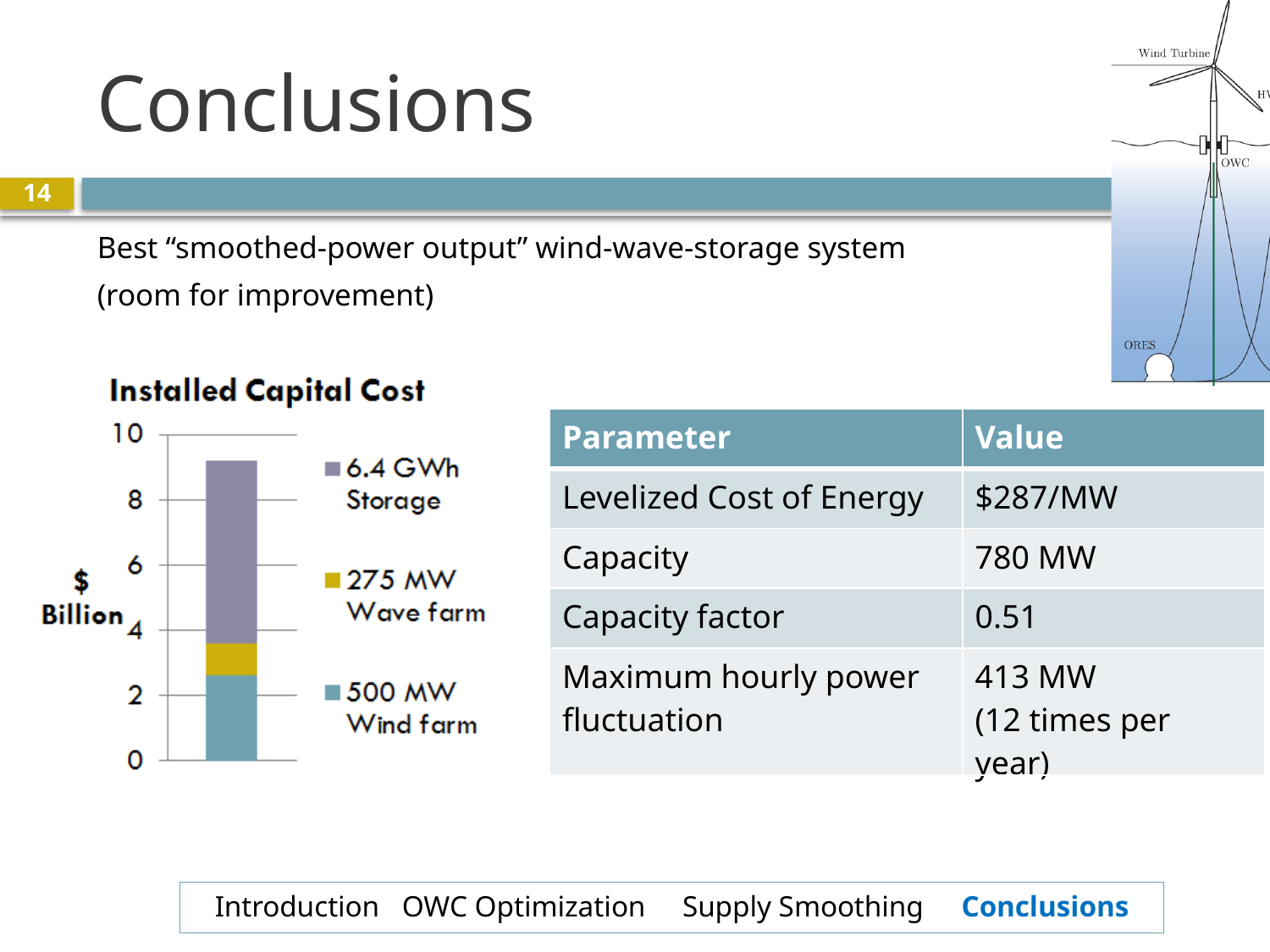
What is the unit shown on the vertical axis of the Installed Capital Cost chart? $ Billion Which component accounts for the largest share of the installed capital cost in the chart? 6.4 GWh Storage What kind of chart is the Installed Capital Cost chart? stacked bar chart Which is larger in the Installed Capital Cost chart, the 500 MW Wind farm segment or the 275 MW Wave farm segment? 500 MW Wind farm What is the title of the chart on the slide? Installed Capital Cost How many bars are plotted in the Installed Capital Cost chart? 1 Is the installed capital cost of the 500 MW Wind farm greater or less than 4 $ Billion? less Is the installed capital cost of the 6.4 GWh Storage segment greater or less than 4 $ Billion? greater How many series does the legend of the Installed Capital Cost chart list? 3 Is the total installed capital cost shown by the stacked bar greater or less than 8 $ Billion? greater Which component accounts for the smallest share of the installed capital cost in the chart? 275 MW Wave farm Which is larger in the Installed Capital Cost chart, the 6.4 GWh Storage segment or the 500 MW Wind farm segment? 6.4 GWh Storage